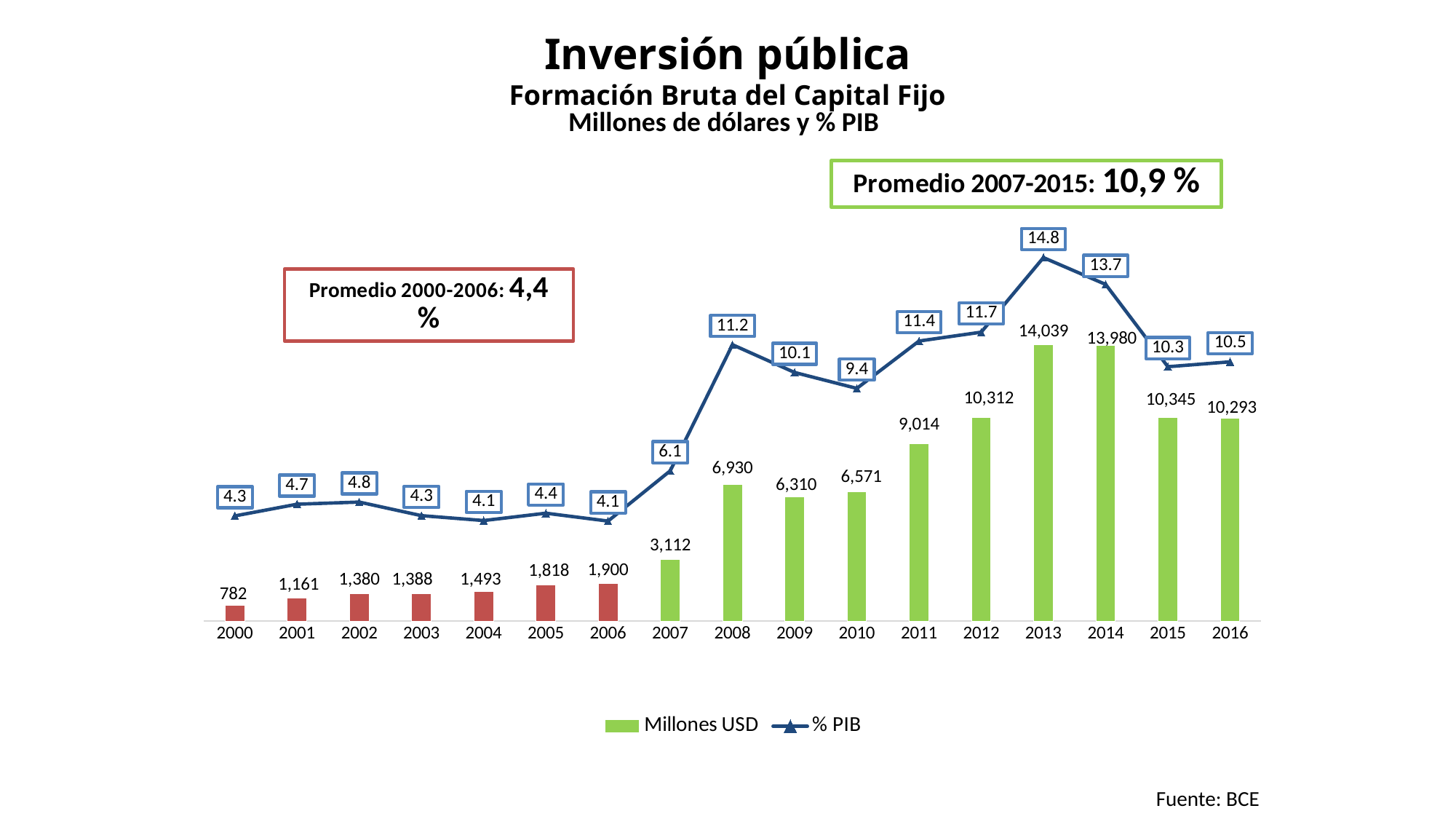
What is the Millones USD value for 2000? 782 What is the Millones USD value for 2013? 14,039 What kind of chart is used for the Millones USD series? bar chart What is the difference in Millones USD between 2013 and 2014? 59 Which year has the lowest Millones USD value? 2000 What is the average % PIB for 2007-2015 shown in the green box? 10,9 % Which year has the highest % PIB value? 2013 How many series does the legend list? 2 Which is larger, the Millones USD value for 2015 or for 2016? 2015 What is the % PIB value for 2008? 11.2 Does the Millones USD value rise or fall from 2000 to 2006? rise How many years are shown on the x axis? 17